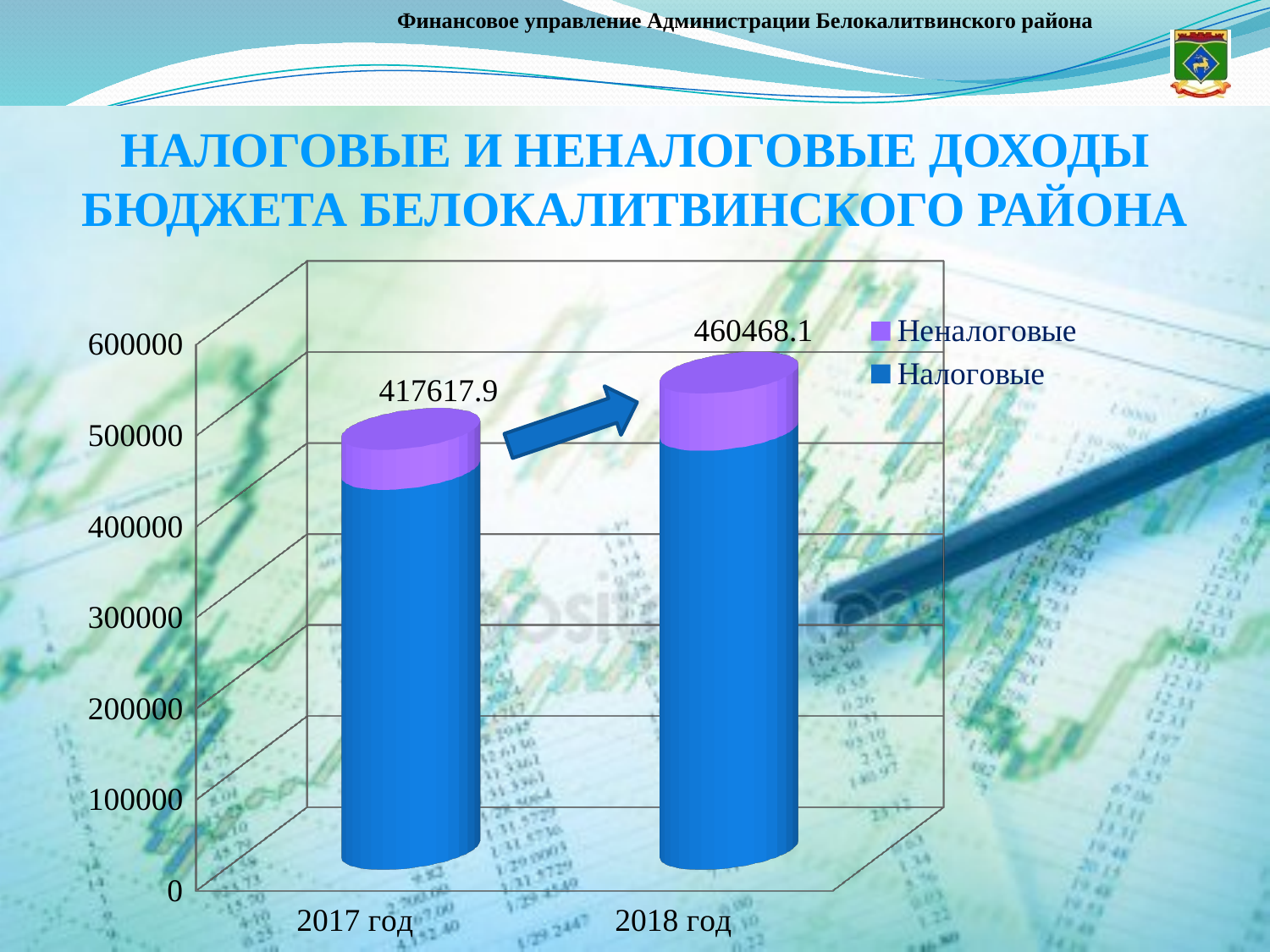
Which year has the higher labelled total, 2017 год or 2018 год? 2018 год Which year has the lowest total on the chart? 2017 год How many years (categories) are shown on the x axis? 2 Do the totals rise or fall from 2017 год to 2018 год? Rise Is the Налоговые value for 2018 год greater or less than 400000? greater What kind of chart is shown on the slide? Stacked bar chart How many series does the legend list? 2 Which year has the highest total on the chart? 2018 год Which series is shown in purple in the legend? Неналоговые